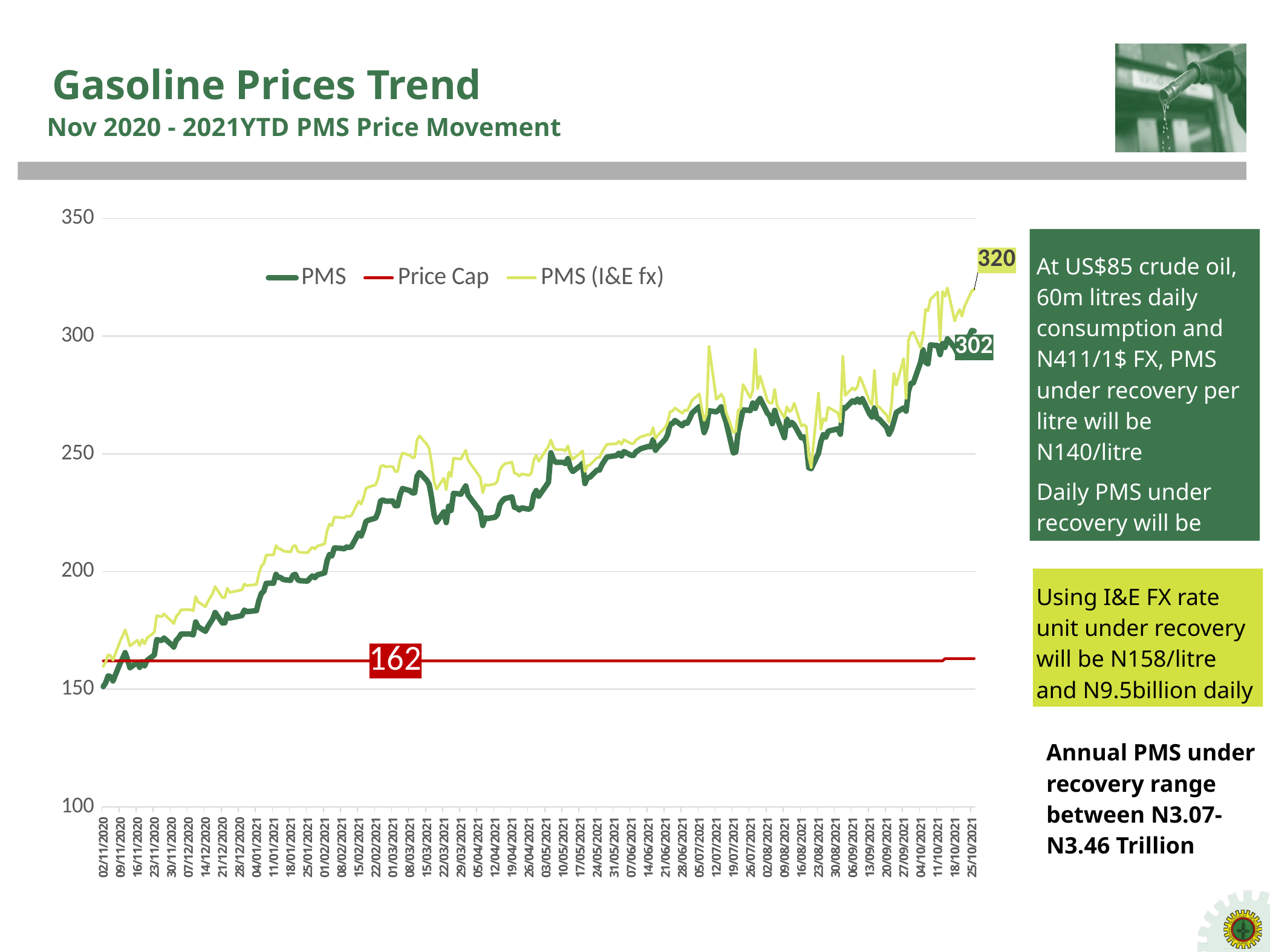
How much higher is the labelled final PMS value than the Price Cap value? 140 Which series has the higher labelled final value, PMS or PMS (I&E fx)? PMS (I&E fx) How many series does the legend list? 3 What is the labelled final value of the PMS series? 302 Is the PMS value at 02/11/2020 greater or less than 200? less What colour is the Price Cap line in the legend? Red How much higher is the labelled final PMS (I&E fx) value than the Price Cap value? 158 What is the labelled final value of the PMS (I&E fx) series? 320 What kind of chart is shown on the slide? Line chart What value is labelled on the Price Cap line? 162 Does the PMS series generally rise or fall from November 2020 to October 2021? Rise What is the difference between the labelled final values of PMS (I&E fx) and PMS? 18